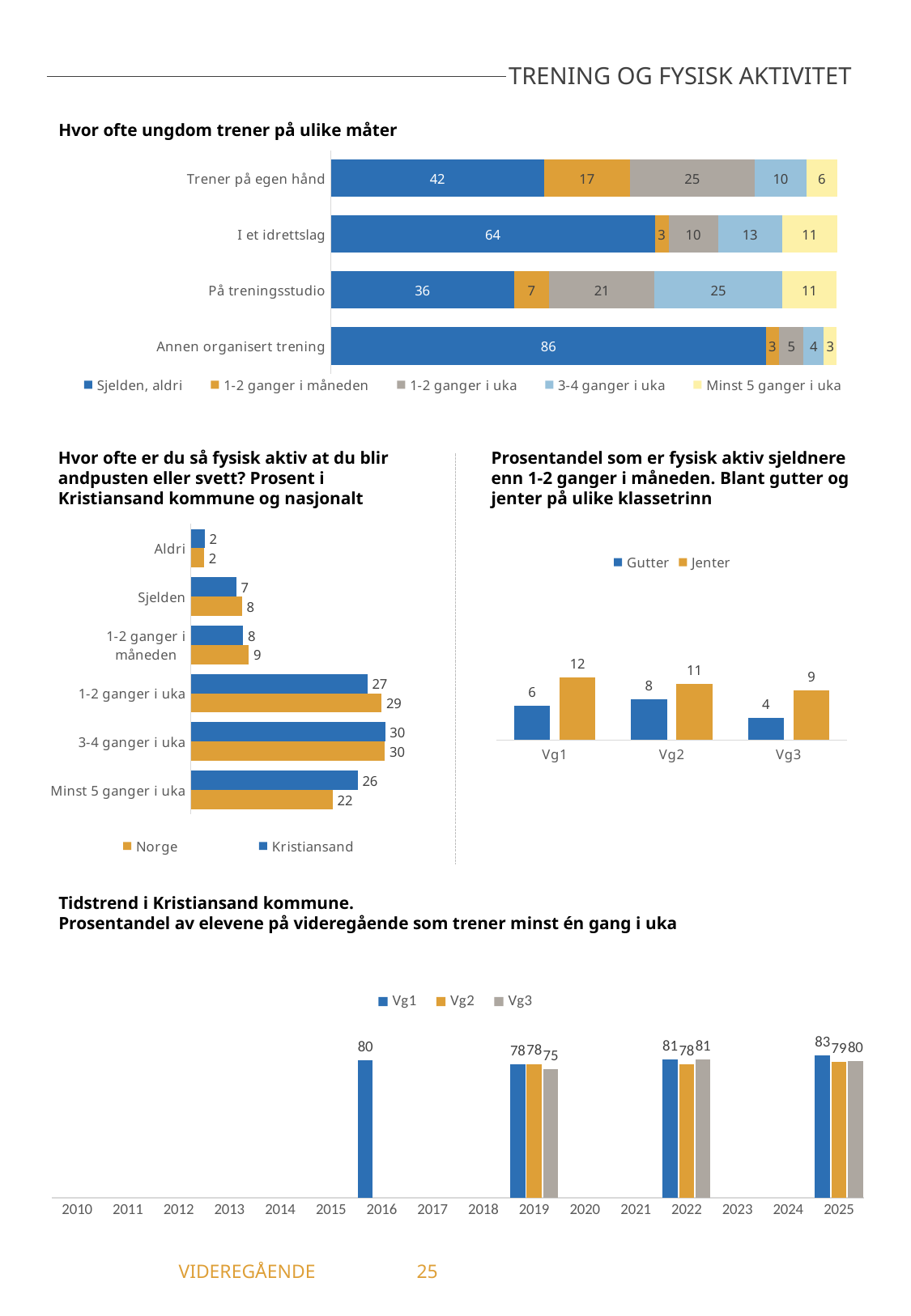
In the chart 'Hvor ofte ungdom trener på ulike måter', what is the total of the 'Trener på egen hånd' bar? 100 In the chart 'Hvor ofte ungdom trener på ulike måter', what is the value for 'Sjelden, aldri' in the 'Annen organisert trening' bar? 86 In the chart 'Hvor ofte ungdom trener på ulike måter', what is the value for '3-4 ganger i uka' in the 'På treningsstudio' bar? 25 In the chart 'Prosentandel som er fysisk aktiv sjeldnere enn 1-2 ganger i måneden', what kind of chart is it? Bar chart In the chart 'Tidstrend i Kristiansand kommune', what is the value for Vg3 in 2019? 75 In the chart 'Prosentandel som er fysisk aktiv sjeldnere enn 1-2 ganger i måneden', which class level has the lowest value for Gutter? Vg3 In the chart 'Hvor ofte er du så fysisk aktiv at du blir andpusten eller svett?', how many categories are shown? 6 In the chart 'Hvor ofte er du så fysisk aktiv at du blir andpusten eller svett?', what is the value for Kristiansand in the '1-2 ganger i uka' category? 27 In the chart 'Hvor ofte er du så fysisk aktiv at du blir andpusten eller svett?', what is the difference between Kristiansand and Norge for 'Minst 5 ganger i uka'? 4 In the chart 'Prosentandel som er fysisk aktiv sjeldnere enn 1-2 ganger i måneden', what is the value for Jenter at Vg1? 12 In the chart 'Tidstrend i Kristiansand kommune', does the Vg1 value rise or fall from 2019 to 2025? Rise In the chart 'Hvor ofte ungdom trener på ulike måter', how many series does the legend list? 5